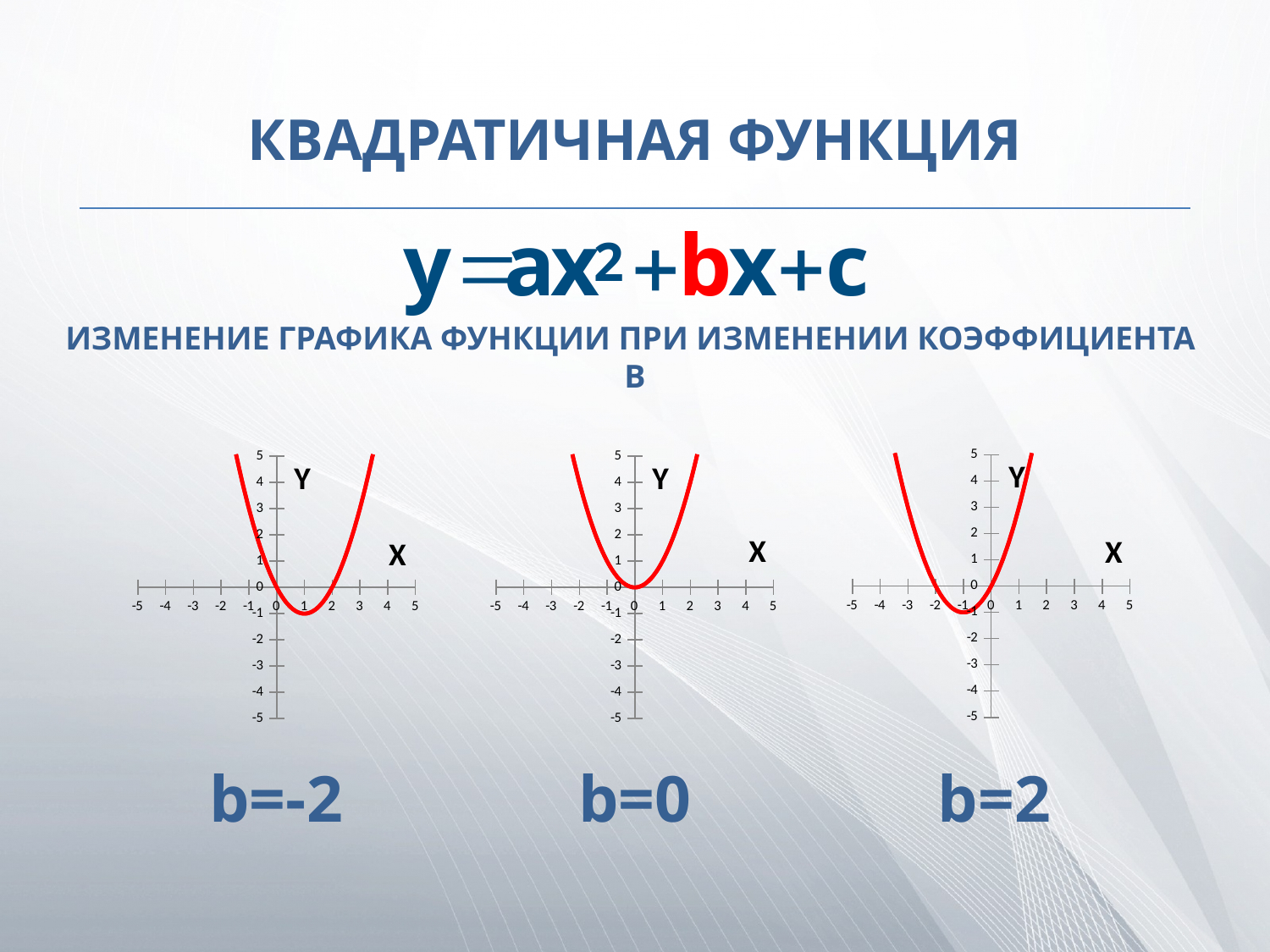
In the b=-2 chart, what is the y value at the lowest point of the curve? -1 What kind of chart is the b=0 chart? line chart In the b=2 chart, is the lowest value of the curve greater or less than 0? less In the b=-2 chart, at what x value does the curve reach its lowest point? 1 How many charts are shown on the slide? 3 What colour is the curve in the b=0 chart? red In the b=2 chart, at what x value does the curve reach its lowest point? -1 In the b=-2 chart, do the values rise or fall as x increases from -1 to 1? fall In the b=0 chart, what is the y value of the curve at x = 0? 0 What is the highest value shown on the Y axis of the b=2 chart? 5 Which chart has the lowest point of its curve on the Y axis: b=-2, b=0 or b=2? b=0 In the b=0 chart, do the values rise or fall as x increases from 0 to 2? rise